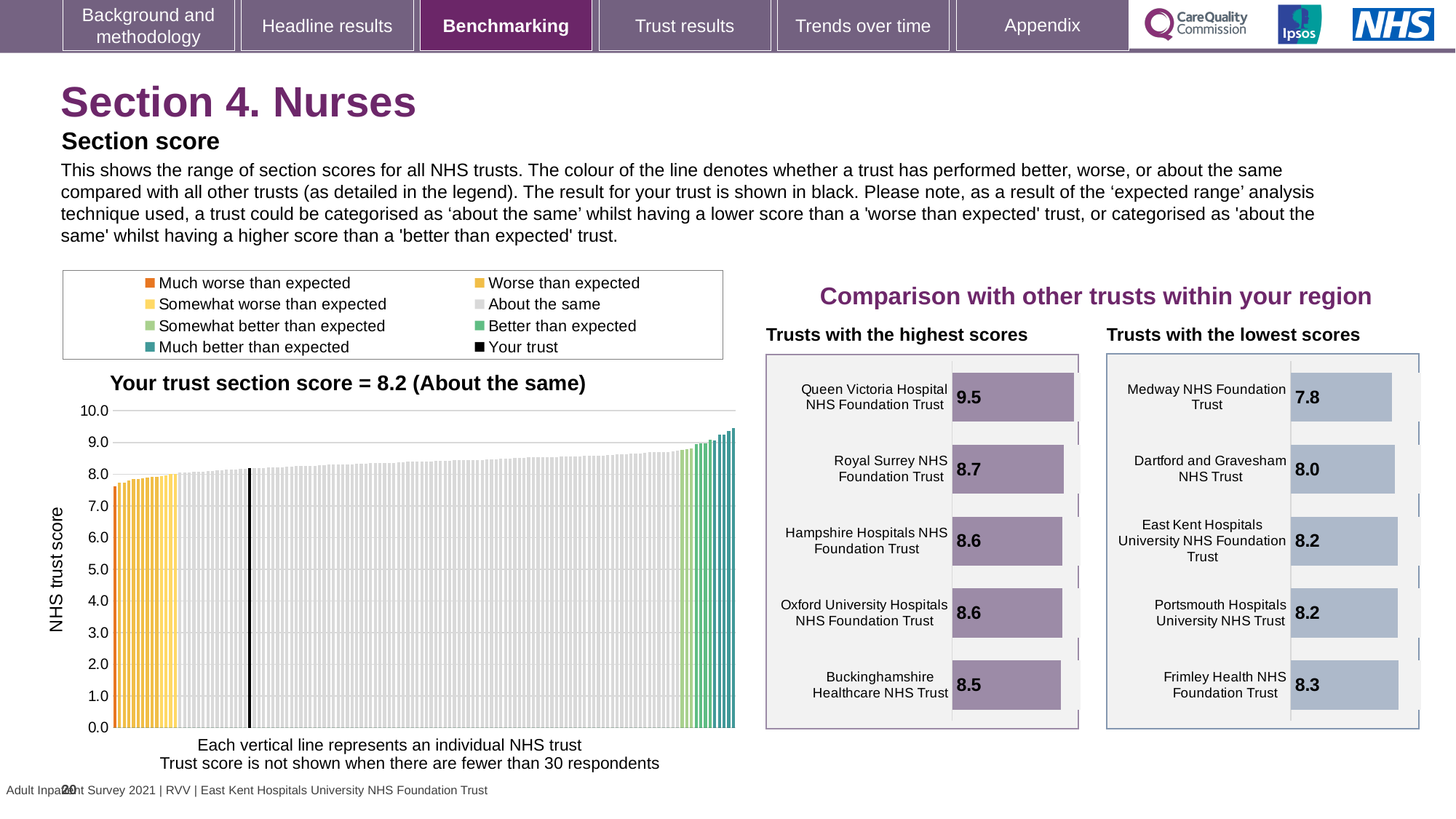
In the 'Your trust section score' chart on the left, do the trust scores rise or fall from left to right? rise In the 'Trusts with the lowest scores' chart, which trust has the lowest score? Medway NHS Foundation Trust In the 'Trusts with the lowest scores' chart, what is the score for Frimley Health NHS Foundation Trust? 8.3 In the 'Trusts with the lowest scores' chart, what is the difference between the scores of Frimley Health NHS Foundation Trust and Medway NHS Foundation Trust? 0.5 In the 'Trusts with the highest scores' chart, what is the score for Queen Victoria Hospital NHS Foundation Trust? 9.5 In the 'Trusts with the highest scores' chart, what is the difference between the scores of Queen Victoria Hospital NHS Foundation Trust and Royal Surrey NHS Foundation Trust? 0.8 How many trusts are shown in the 'Trusts with the lowest scores' chart? 5 In the 'Trusts with the highest scores' chart, which trust has the highest score? Queen Victoria Hospital NHS Foundation Trust What kind of chart is the 'Your trust section score' chart on the left of the slide? bar chart How many entries does the legend above the 'Your trust section score' chart list? 8 In the 'Trusts with the lowest scores' chart, what is the score for Medway NHS Foundation Trust? 7.8 In the 'Trusts with the highest scores' chart, which has the higher score: Hampshire Hospitals NHS Foundation Trust or Buckinghamshire Healthcare NHS Trust? Hampshire Hospitals NHS Foundation Trust